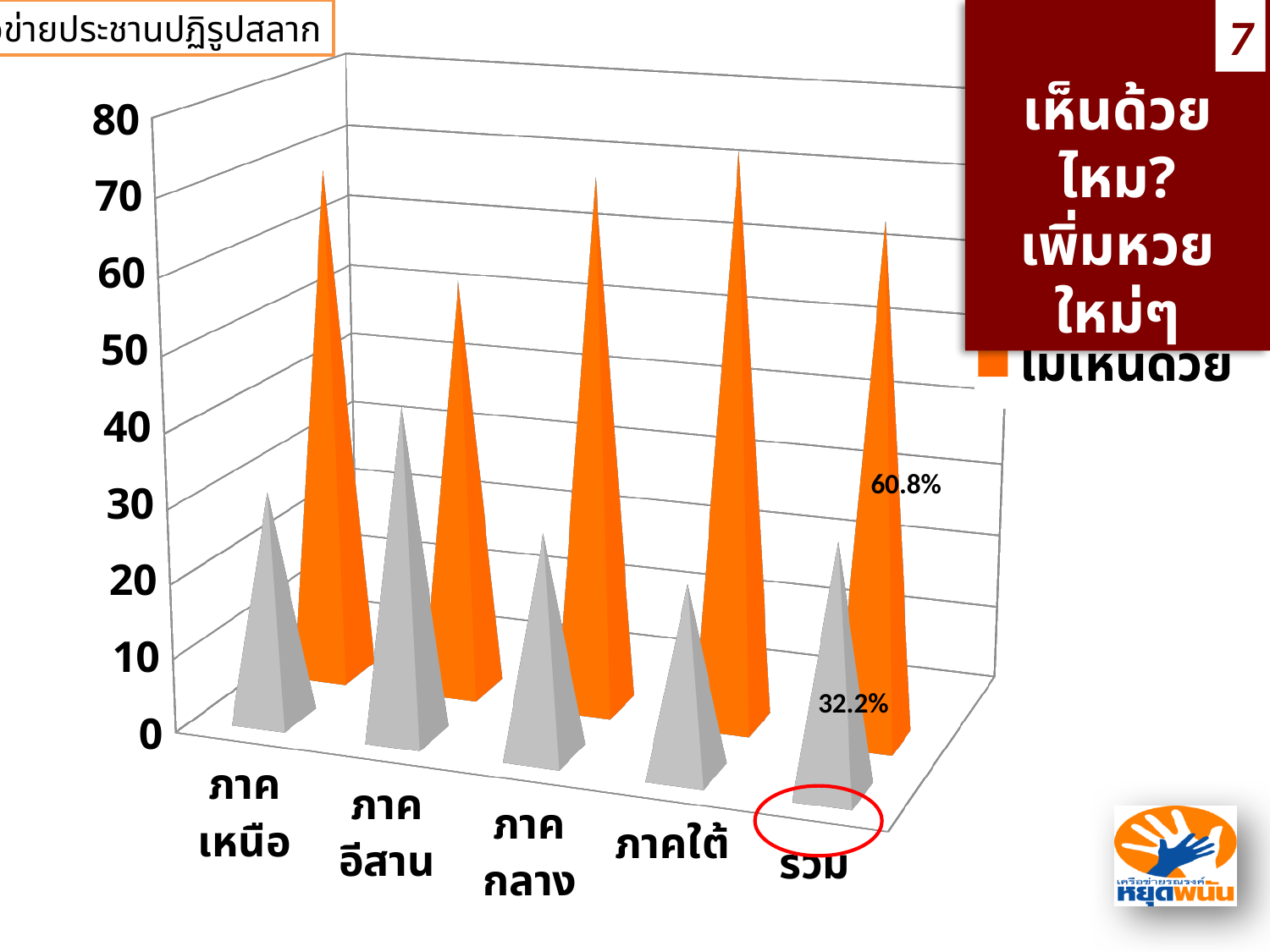
Which has the larger ไม่เห็นด้วย value: ภาคอีสาน or ภาคใต้? ภาคใต้ Which category has the highest value in the grey series? ภาคอีสาน What is the value of the grey series for รวม? 32.2% Which category label is circled in red on the chart? รวม For รวม, what is the difference between the ไม่เห็นด้วย value and the grey series value? 28.6% Is the ไม่เห็นด้วย value for ภาคอีสาน greater or less than 40? greater How many categories are shown on the x axis? 5 What is the value for รวม in the ไม่เห็นด้วย series? 60.8% Which category has the lowest ไม่เห็นด้วย value? ภาคอีสาน What colour represents the ไม่เห็นด้วย series? orange What kind of chart is shown on the slide? bar chart For รวม, which is larger: the ไม่เห็นด้วย value or the grey series value? ไม่เห็นด้วย